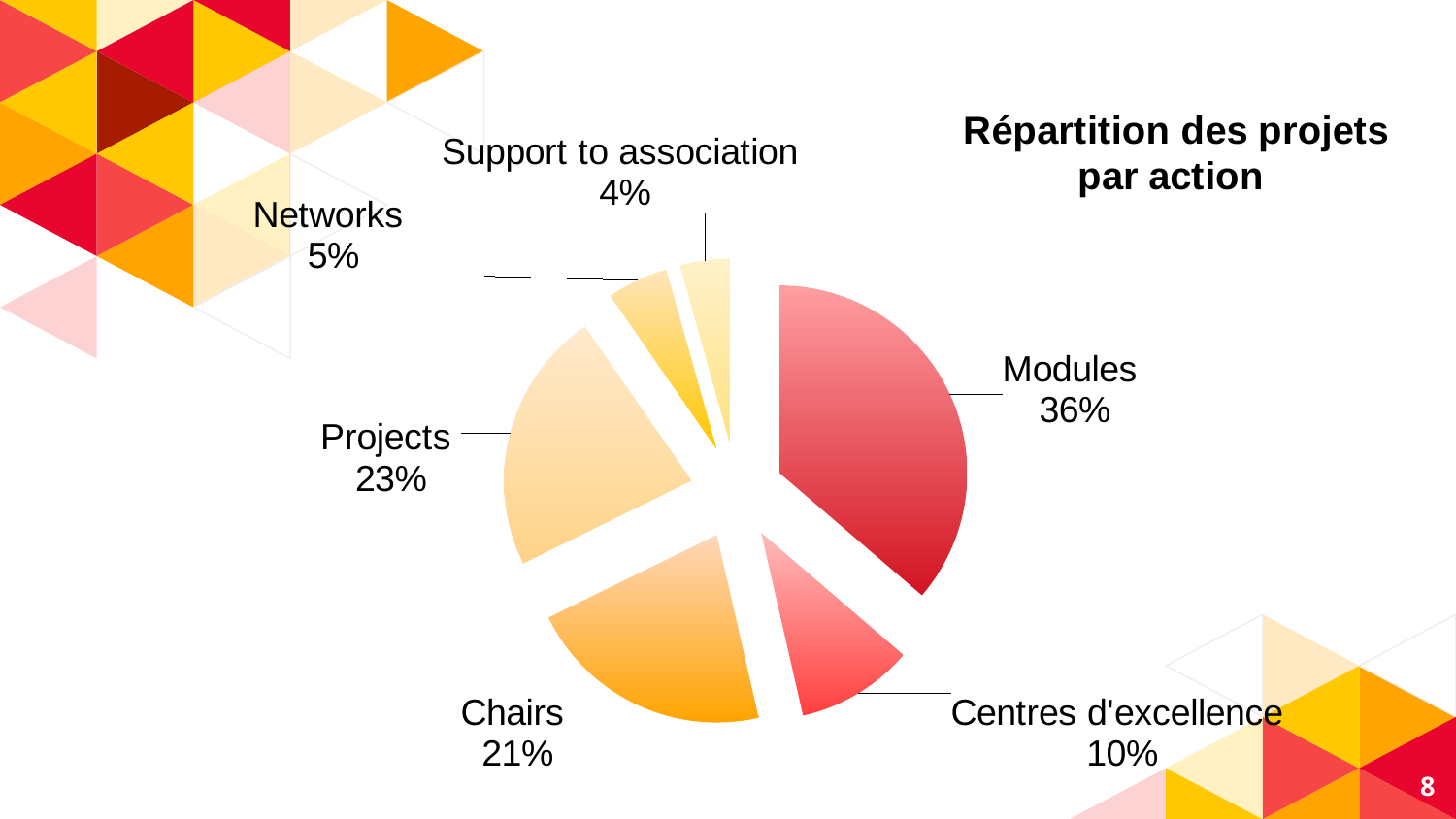
What share of the pie is Chairs? 21% Which category has the smallest share of the pie? Support to association What share of the pie is Modules? 36% What share of the pie is Support to association? 4% What is the difference between the shares of Modules and Projects? 13% What is the combined share of Networks and Support to association? 9% What is the difference between the shares of Centres d'excellence and Networks? 5% What is the title of the chart? Répartition des projets par action How many categories are shown in the pie chart? 6 Which is larger, the share for Projects or the share for Chairs? Projects Which category has the largest share of the pie? Modules What kind of chart is shown on the slide? pie chart